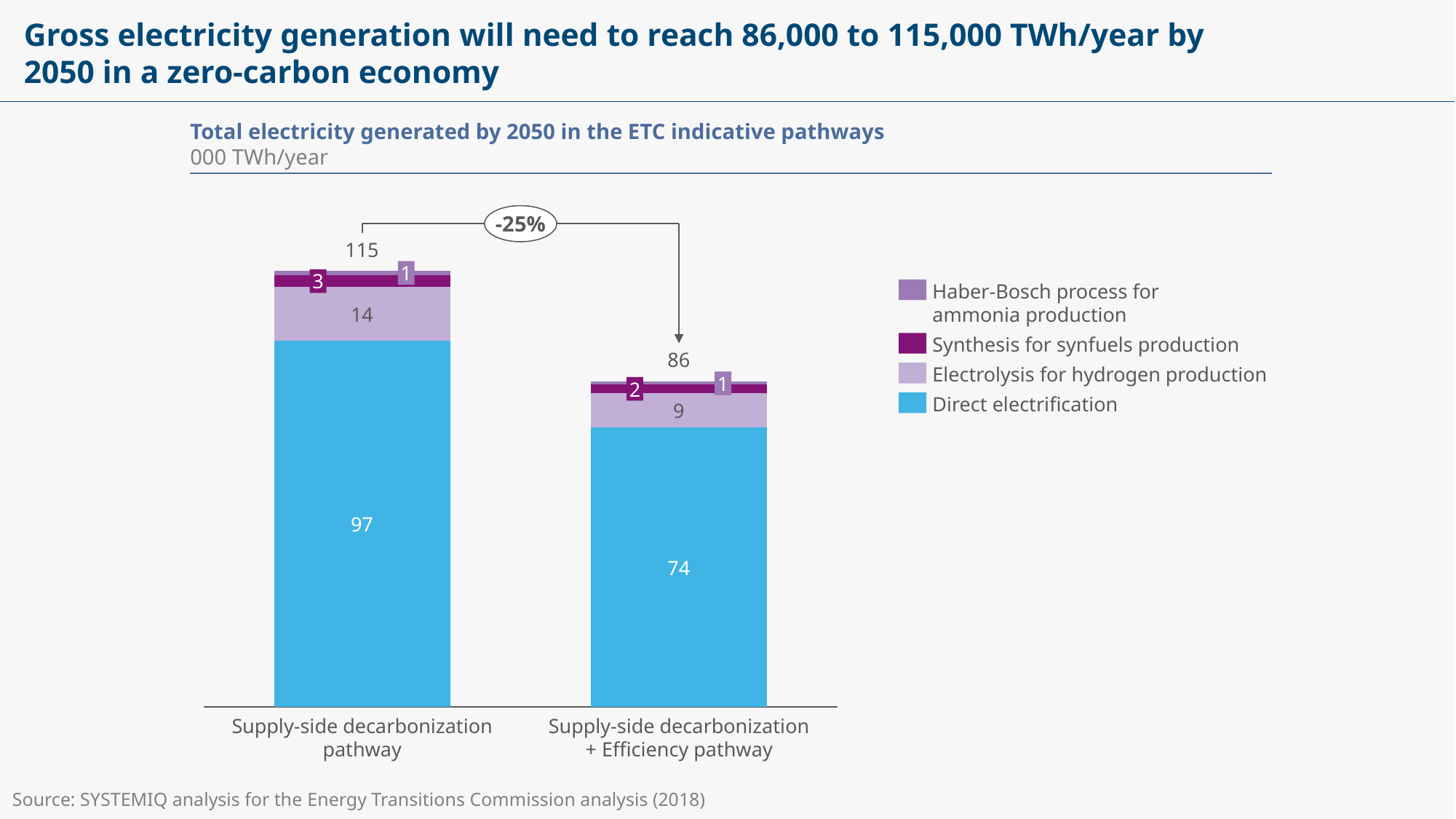
How many series does the legend list? 4 What percentage change is shown in the callout between the two bars? -25% How many pathways (categories) are shown on the x axis? 2 Which is larger: Electrolysis for hydrogen production in the Supply-side decarbonization pathway or in the Supply-side decarbonization + Efficiency pathway? Supply-side decarbonization pathway Which pathway has the higher total electricity generated? Supply-side decarbonization pathway What is the total of the stacked bar for the Supply-side decarbonization + Efficiency pathway? 86 What kind of chart is shown? Stacked bar chart What is the Direct electrification value for the Supply-side decarbonization pathway? 97 What is the Synthesis for synfuels production value for the Supply-side decarbonization pathway? 3 What is the total of the stacked bar for the Supply-side decarbonization pathway? 115 What is the difference in Direct electrification between the Supply-side decarbonization pathway and the Supply-side decarbonization + Efficiency pathway? 23 What is the Electrolysis for hydrogen production value for the Supply-side decarbonization + Efficiency pathway? 9